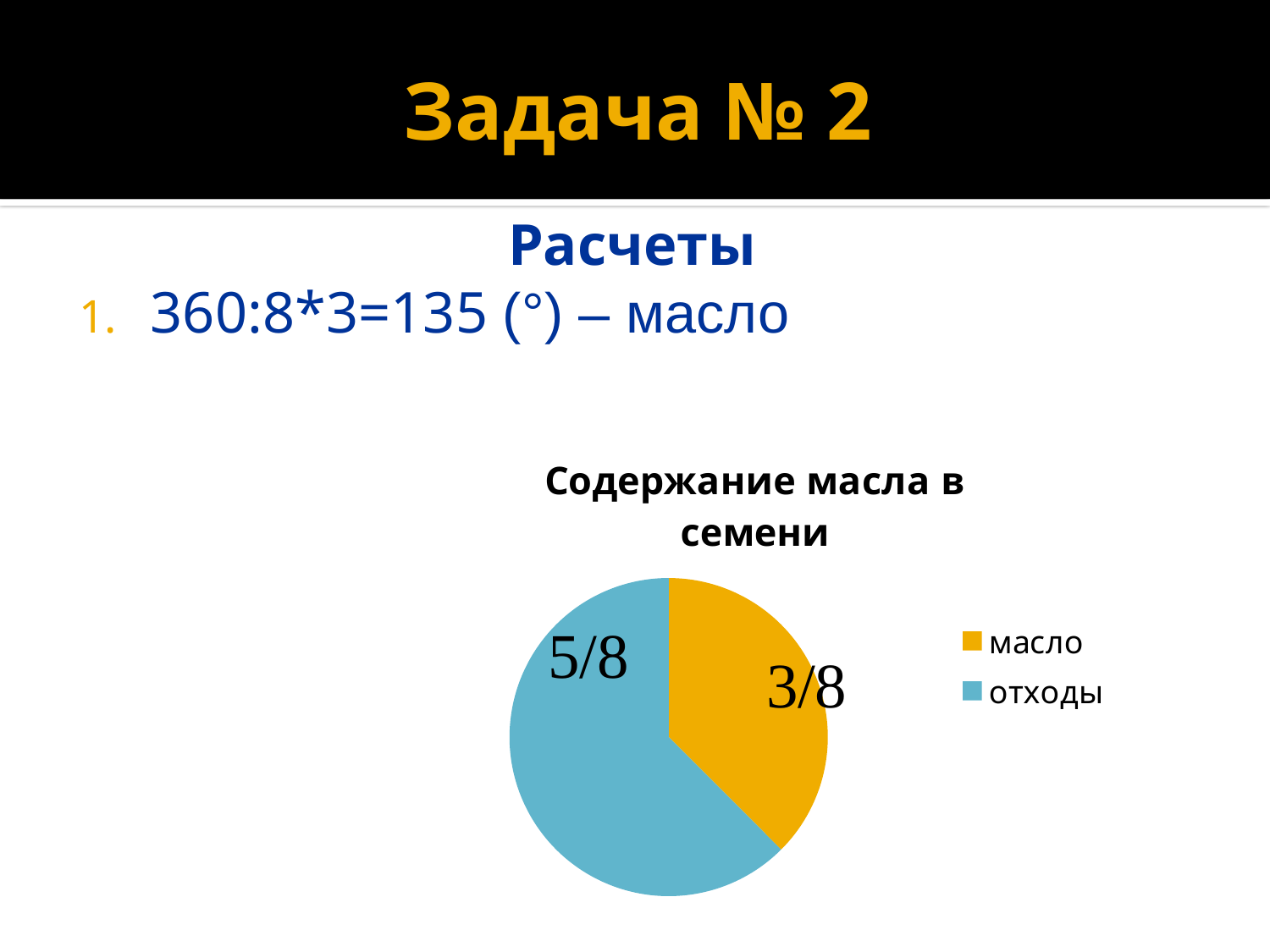
What is the title of the chart? Содержание масла в семени What share of the pie is labelled for масло? 3/8 What kind of chart is shown on the slide? pie chart Which is larger, the масло slice or the отходы slice? отходы Which slice is the largest? отходы How many slices does the pie chart have? 2 How many entries does the legend list? 2 What colour is the масло slice? yellow What share of the pie is labelled for отходы? 5/8 Which slice is the smallest? масло What is the difference between the отходы share and the масло share? 2/8